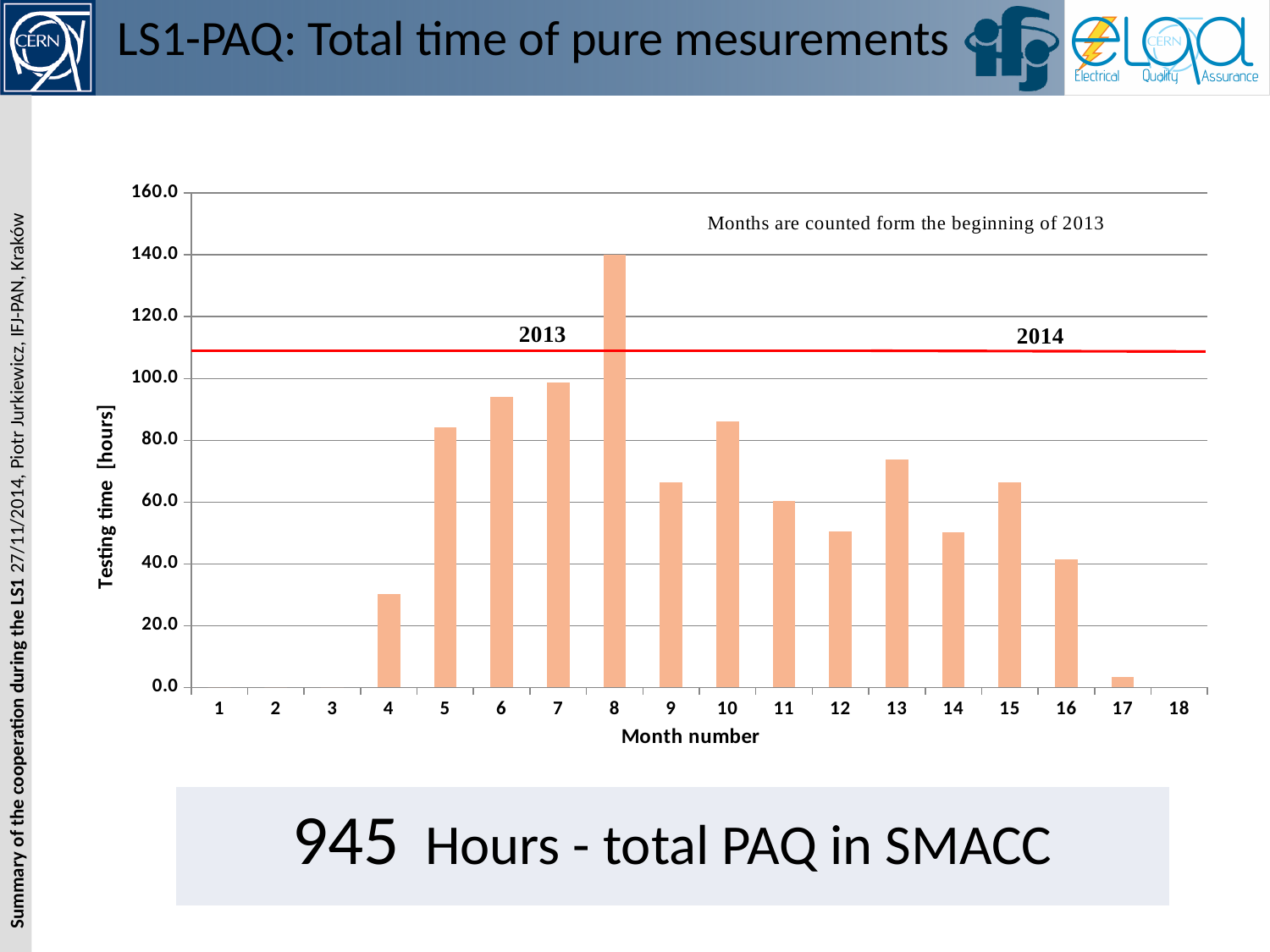
How many month numbers are shown on the x axis? 18 What kind of chart is shown on the slide? bar chart Which has a larger testing time, month 13 or month 16? month 13 Which month number has the highest testing time? 8 Is the testing time for month 4 greater or less than 40.0 hours? less Is the testing time for month 8 greater or less than 120.0 hours? greater What is the label of the y axis? Testing time [hours] Is the testing time for month 17 greater or less than 20.0 hours? less What is the label of the x axis? Month number Do the testing times rise or fall from month 4 to month 8? rise Which has a larger testing time, month 5 or month 9? month 5